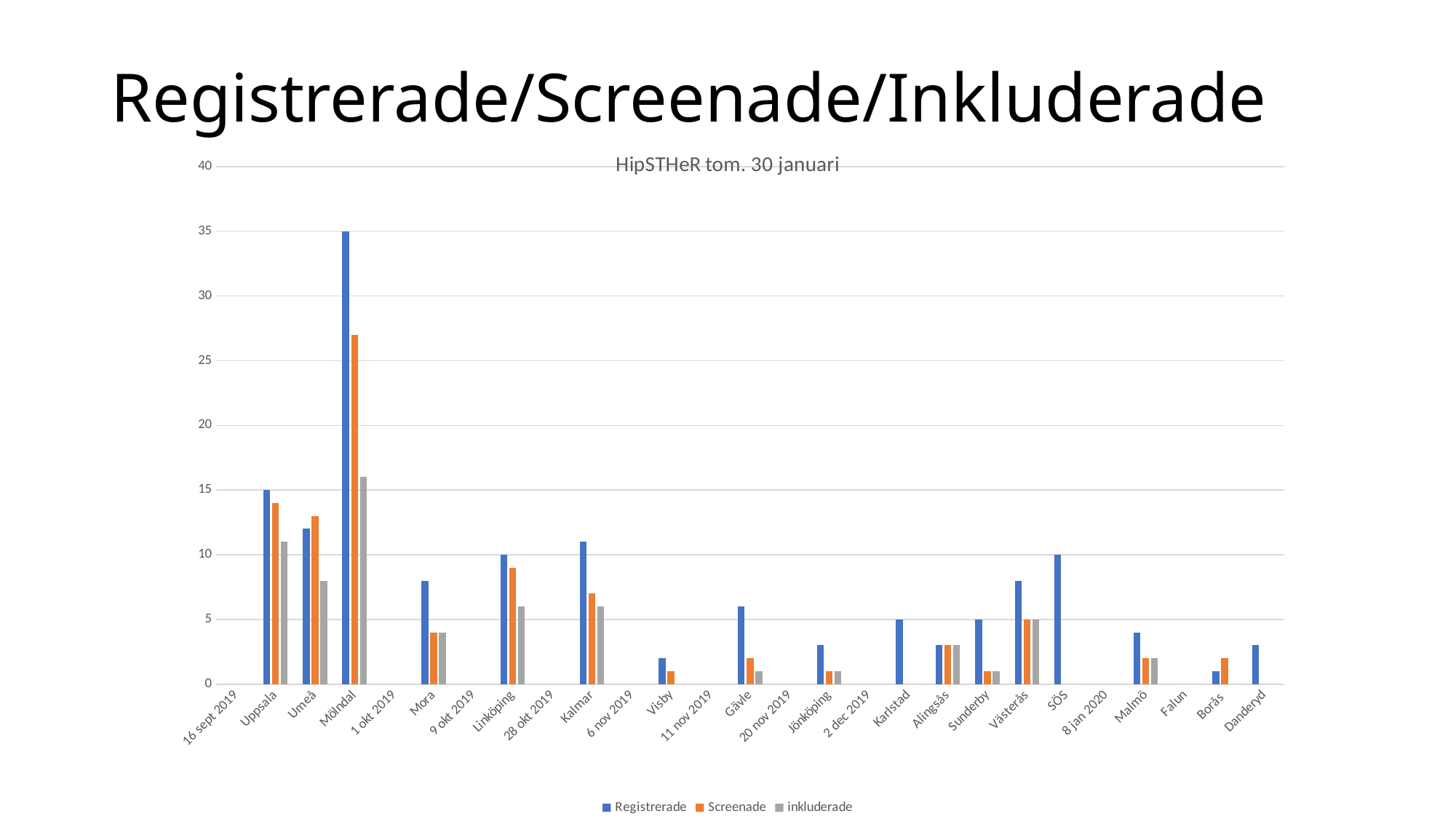
What is the Registrerade value for Karlstad? 5 Is the Screenade value for Mölndal greater or less than 25? greater Is the inkluderade value for Umeå greater or less than 10? less Which has the larger Registrerade value, Uppsala or Umeå? Uppsala What is the Registrerade value for Mölndal? 35 Which has the larger Screenade value, Mölndal or Uppsala? Mölndal Which category has the highest Registrerade value? Mölndal Is the Registrerade value for Mora greater or less than 5? greater How many series does the legend list? 3 What is the title of the chart? HipSTHeR tom. 30 januari What kind of chart is shown on the slide? bar chart What is the Registrerade value for SÖS? 10